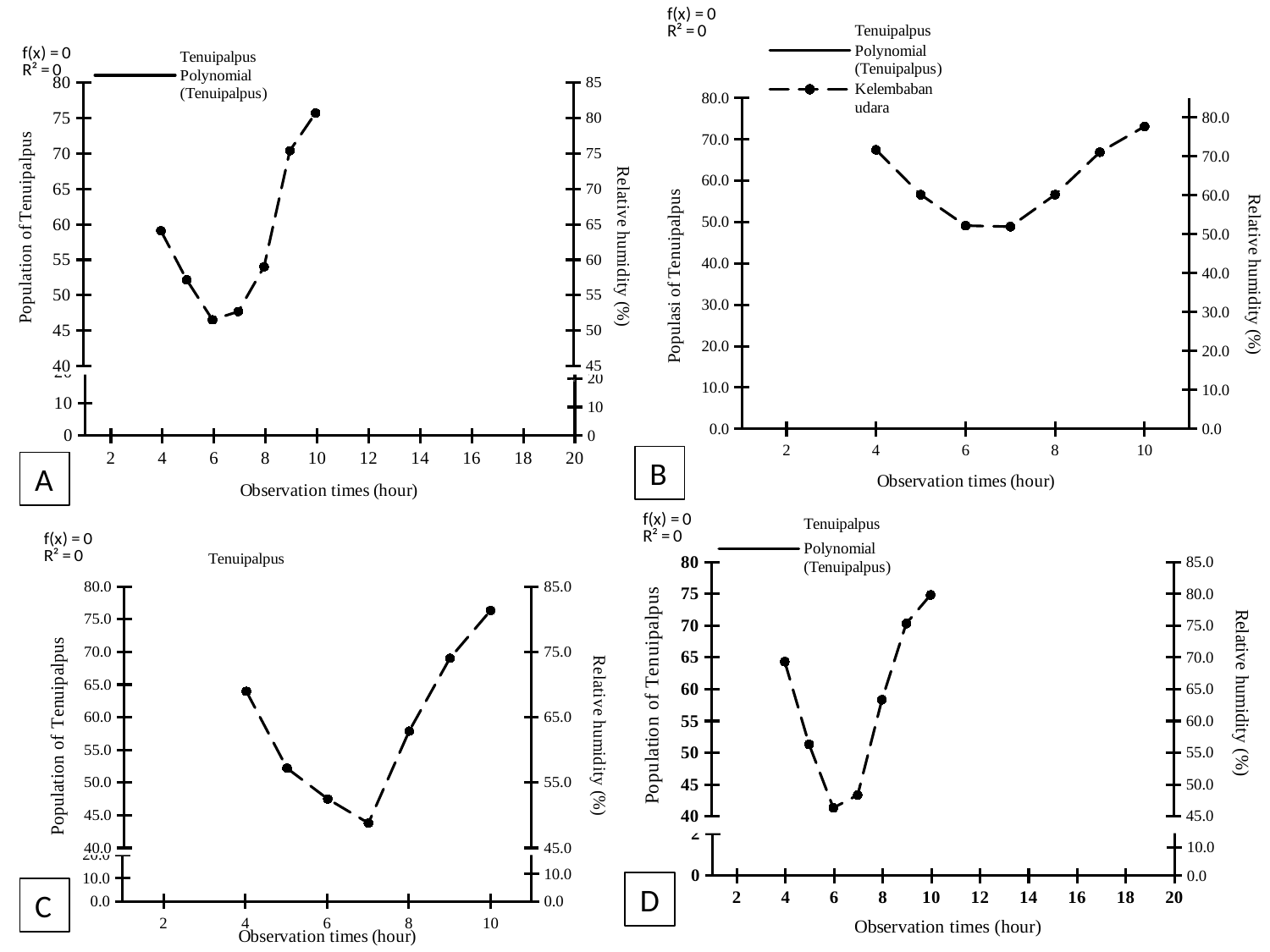
What kind of chart is chart A? line chart In chart B, is the value at hour 10 greater or less than 70.0 on the left axis? greater What is the x-axis title of chart D? Observation times (hour) In chart C, is the value at hour 7 greater or less than 50.0 on the left axis? less In chart D, which is larger: the value at hour 4 or the value at hour 6? hour 4 How many data points are plotted in chart B? 7 How many entries does the legend of chart B list? 2 In chart A, at which observation time (hour) is the plotted value lowest? 6 In chart A, do the values rise or fall from hour 4 to hour 6? fall In chart C, at which observation time (hour) is the plotted value lowest? 7 In chart A, at which observation time (hour) is the plotted value highest? 10 In chart A, is the value at hour 4 greater or less than 55 on the left axis? greater